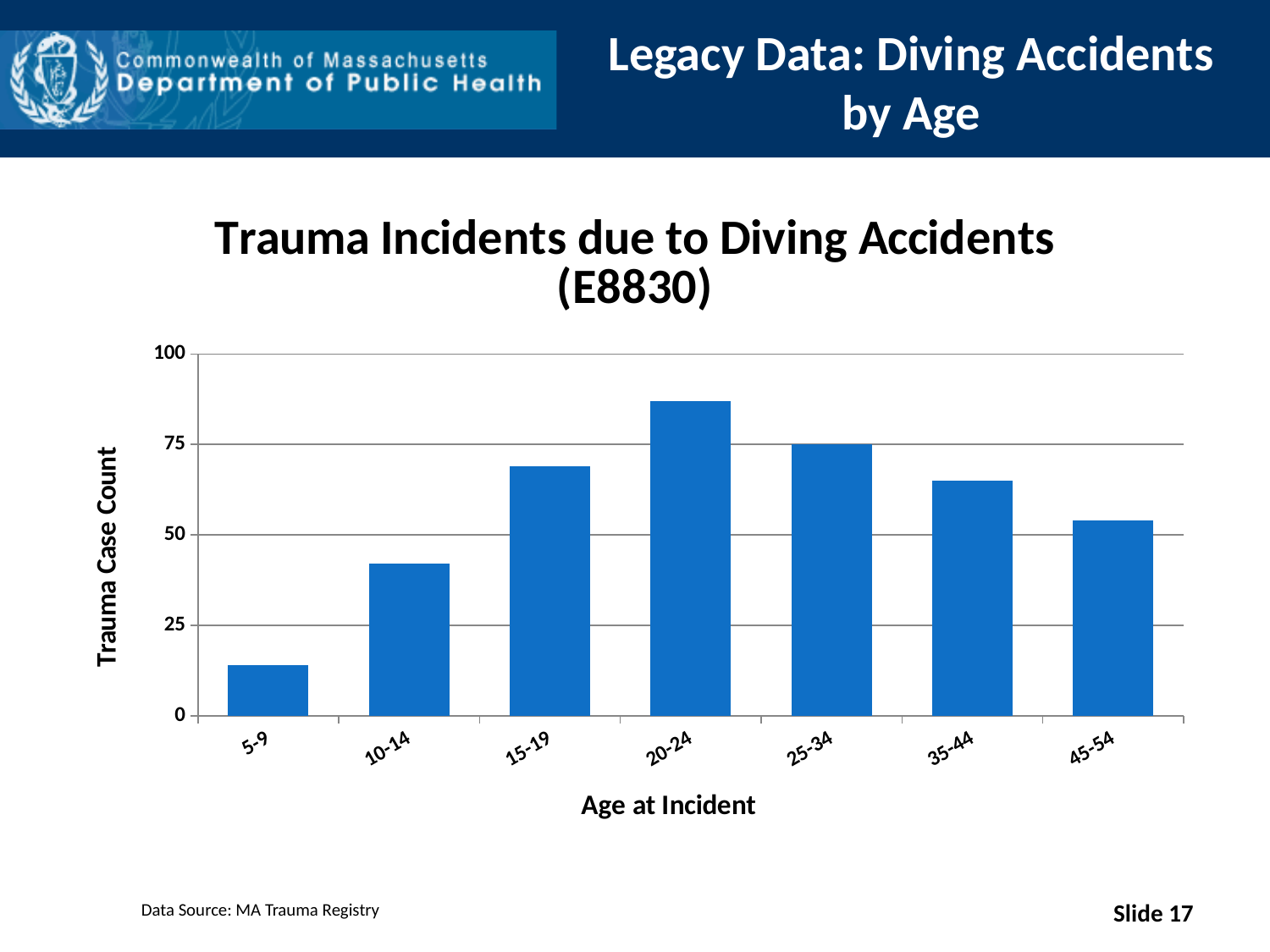
Is the trauma case count for the 20-24 age group greater or less than 75? greater What is the title of the chart? Trauma Incidents due to Diving Accidents (E8830) Which age group has a higher trauma case count, 10-14 or 15-19? 15-19 What kind of chart is shown on the slide? bar chart Is the trauma case count for the 45-54 age group greater or less than 50? greater Is the trauma case count for the 5-9 age group greater or less than 25? less Which age group has the lowest trauma case count? 5-9 How many age groups are shown on the x axis of the chart? 7 What is the label of the vertical axis of the chart? Trauma Case Count Which age group has the highest trauma case count? 20-24 Which age group has a higher trauma case count, 35-44 or 45-54? 35-44